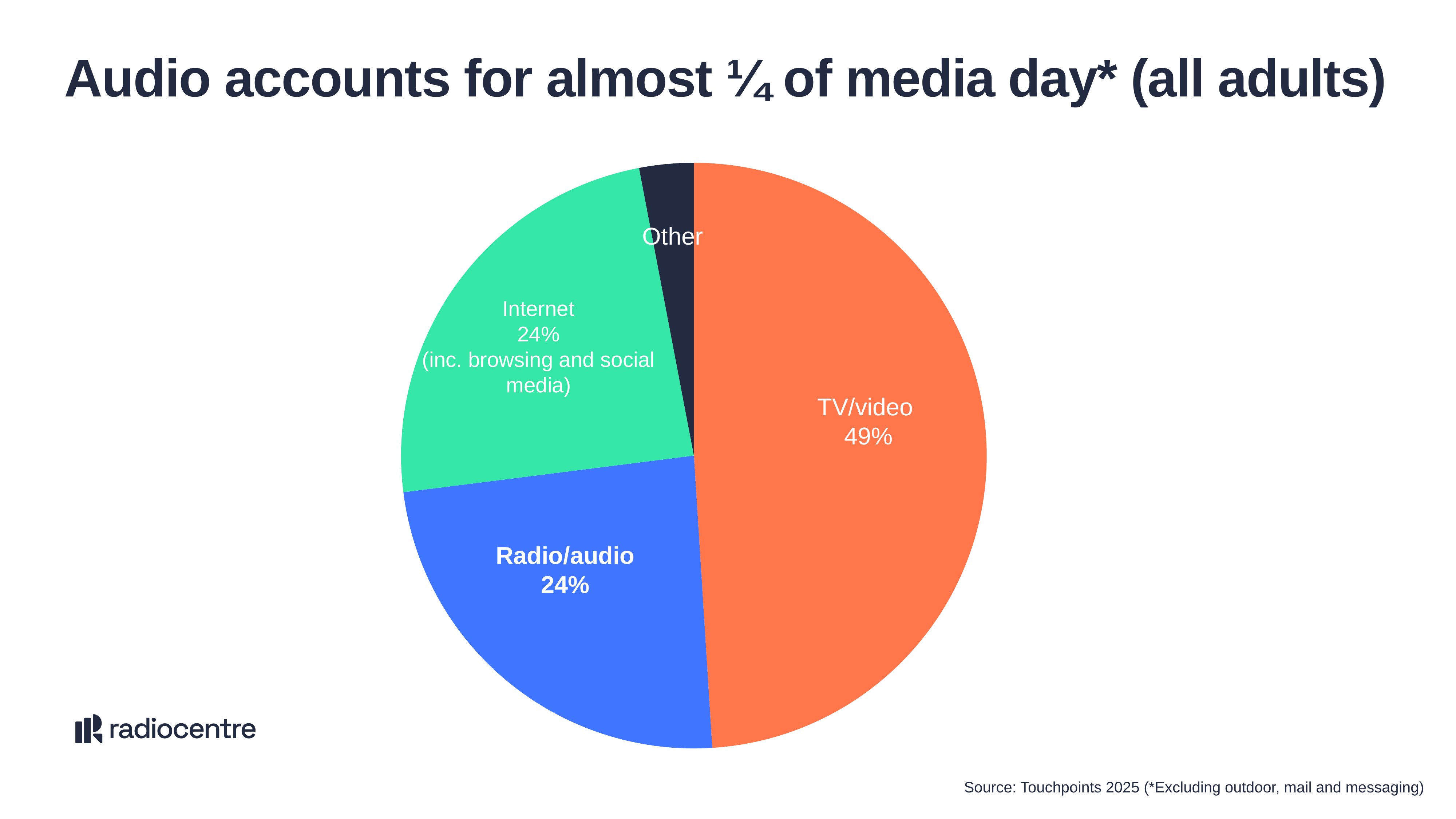
What kind of chart is shown on the slide? Pie chart What is the combined share of Radio/audio and Internet? 48% What is the difference between the TV/video share and the Radio/audio share? 25% What share of the media day does TV/video account for? 49% Which is larger, the TV/video slice or the Internet slice? TV/video What is the source cited for the chart? Touchpoints 2025 How many slices does the pie chart have? 4 Which slice of the pie is the largest? TV/video What colour is the Radio/audio slice? Blue Which slice of the pie is the smallest? Other What share of the media day does Internet (inc. browsing and social media) account for? 24% What share of the media day does Radio/audio account for? 24%